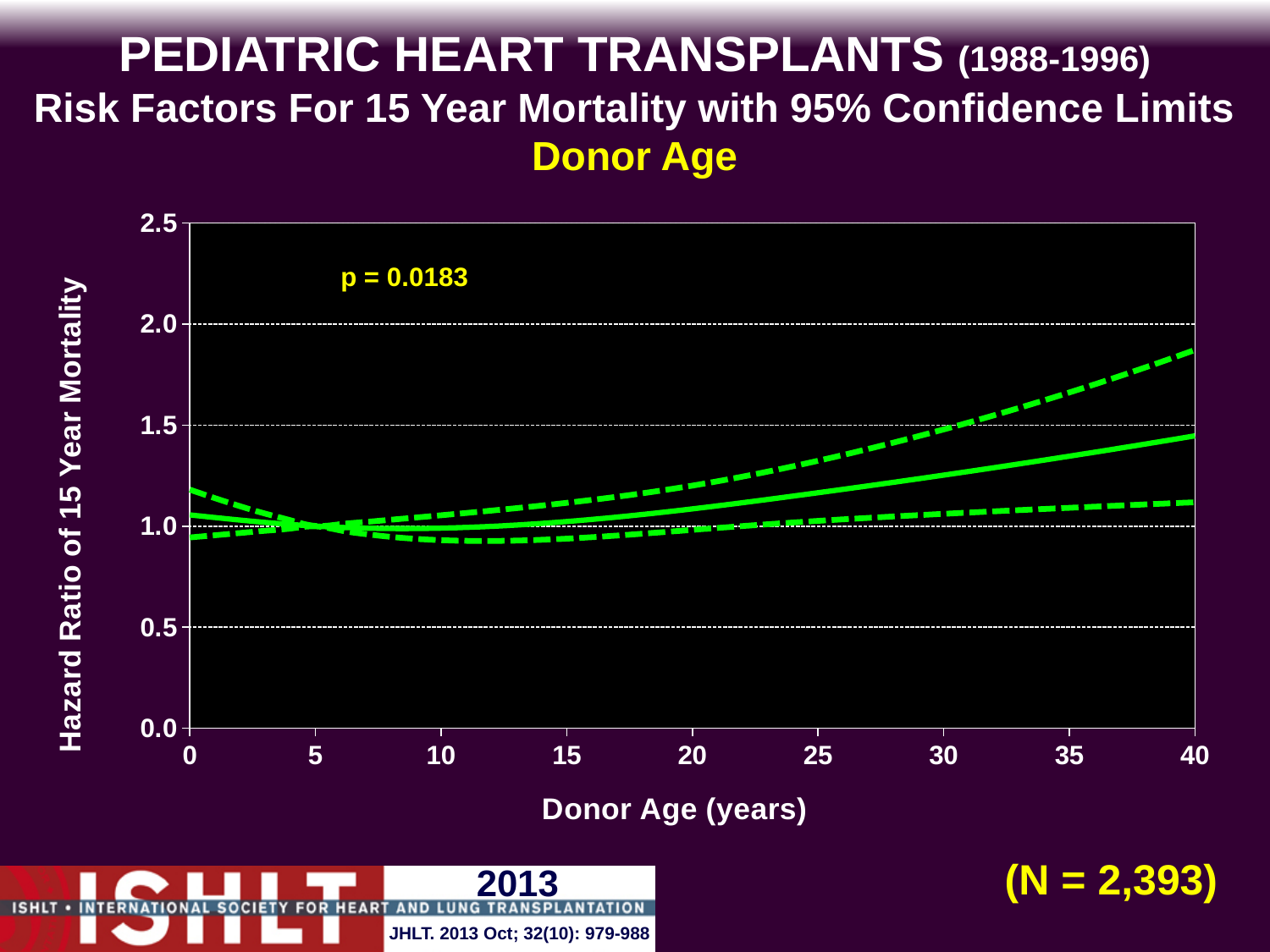
Is the solid hazard ratio line at donor age 40 greater or less than 1.5? less Is the solid hazard ratio line at donor age 40 greater or less than 1.0? greater What is the p-value shown on the chart? p = 0.0183 What kind of chart is shown on the slide? line chart How many lines are plotted on the chart? 3 Does the solid hazard ratio line rise or fall as donor age increases from 20 to 40 years? rise Is the upper dashed confidence limit at donor age 40 greater or less than 1.5? greater What is the label of the x axis? Donor Age (years)